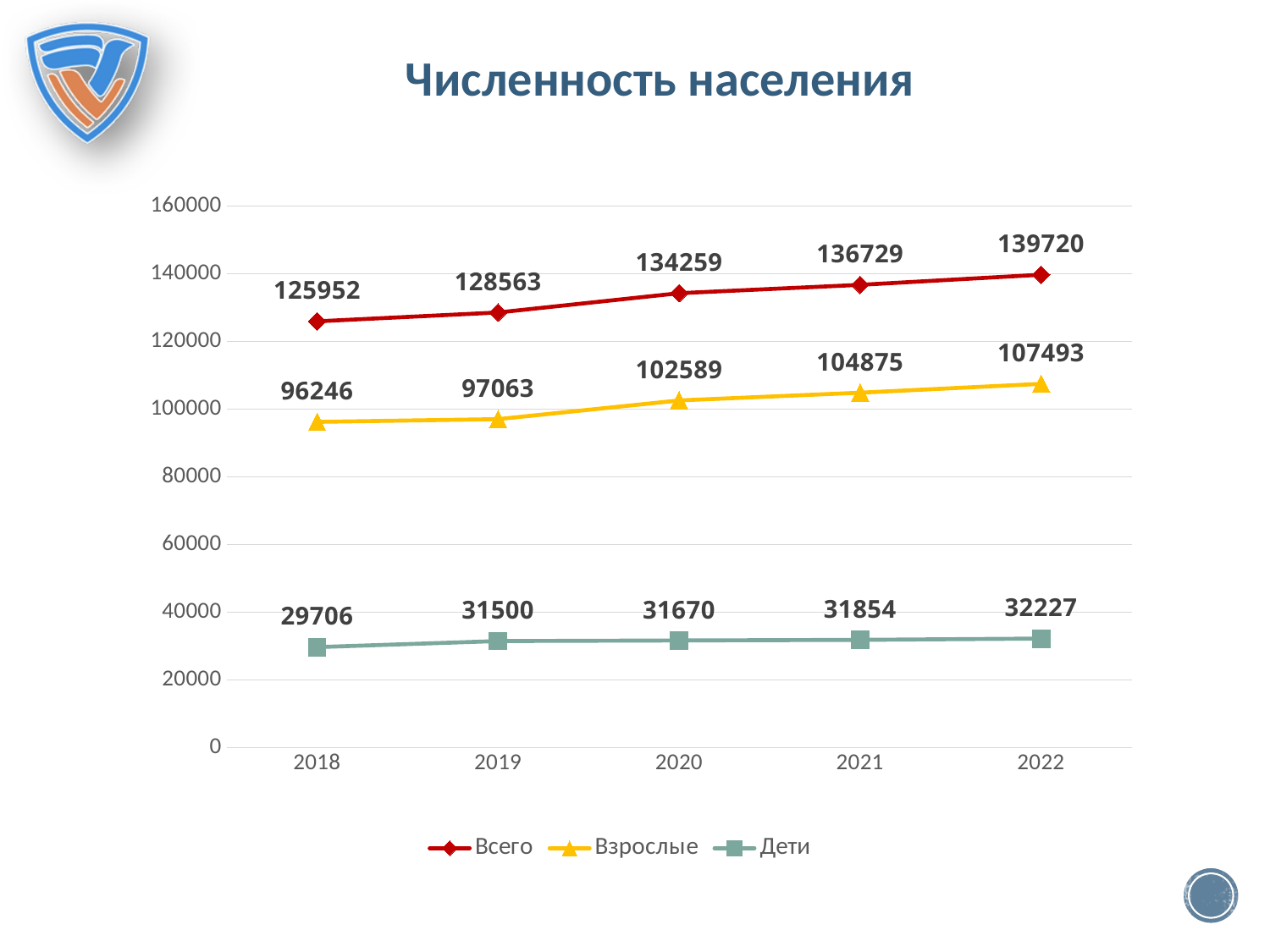
How many years are shown on the x axis? 5 What kind of chart is shown on the slide? line chart In which year is the Дети series lowest? 2018 Which is larger: Взрослые in 2019 or Взрослые in 2020? Взрослые in 2020 What is the value for Всего in 2020? 134259 How many series does the legend list? 3 What is the value for Дети in 2022? 32227 Is the value for Всего in 2022 greater or less than 140000? less In which year is the Всего series highest? 2022 What is the difference between Взрослые and Дети in 2021? 73021 What is the value for Взрослые in 2018? 96246 What is the difference between the Всего values for 2022 and 2018? 13768